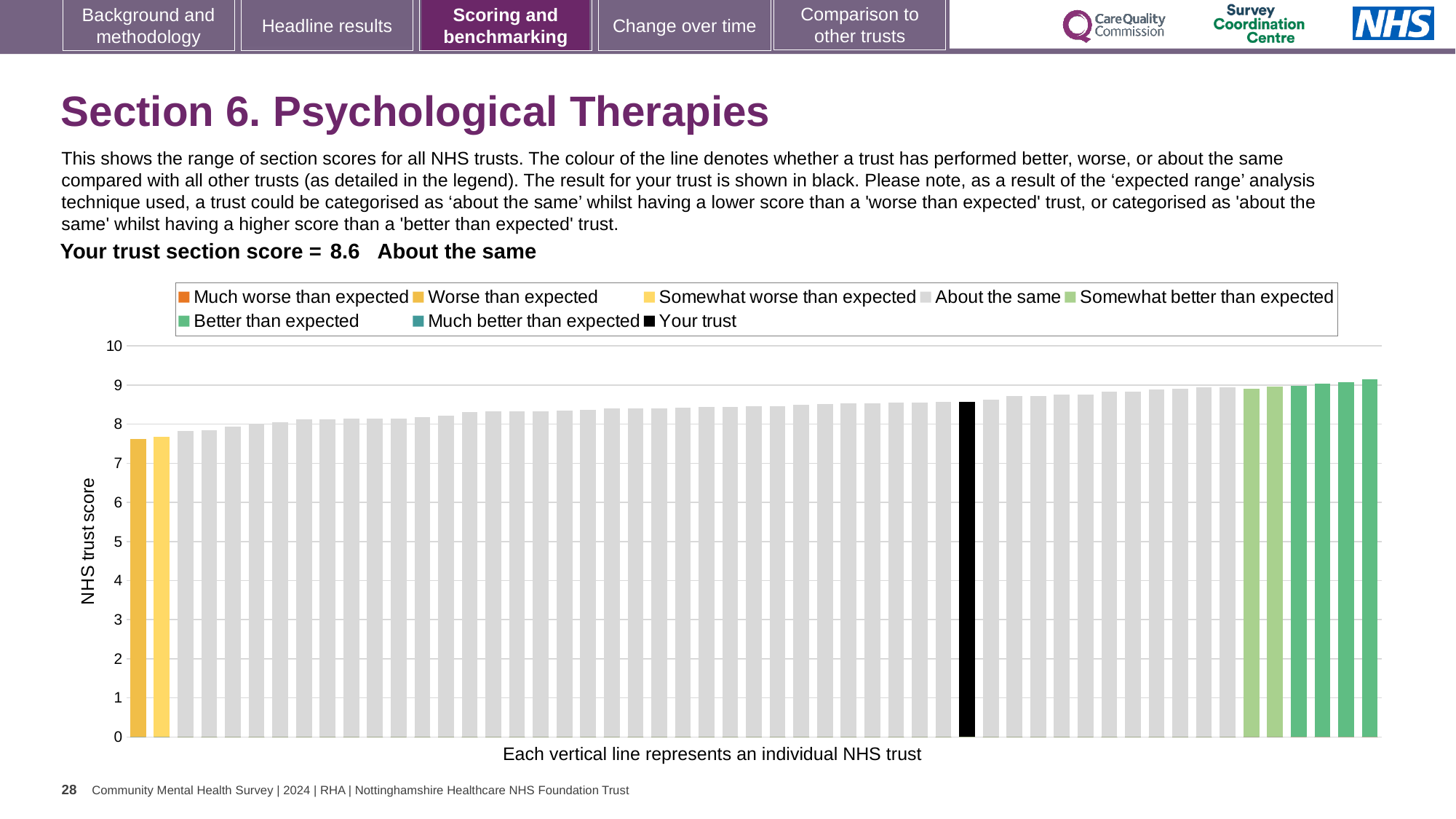
What is the highest value shown on the vertical axis? 10 Which is larger: the bar for your trust or the leftmost bar? the bar for your trust What type of chart is shown on the slide? bar chart Is the value for your trust greater or less than 8? greater Is the value of the tallest bar greater or less than 9? greater What is the label on the vertical axis of the chart? NHS trust score What colour is the bar representing your trust? black Which category is your trust placed in for this section? About the same Is the value of the shortest bar greater or less than 8? less Do the bar values rise or fall from left to right along the x axis? rise What is the section score for your trust shown on the slide? 8.6 How many entries does the chart legend list? 8